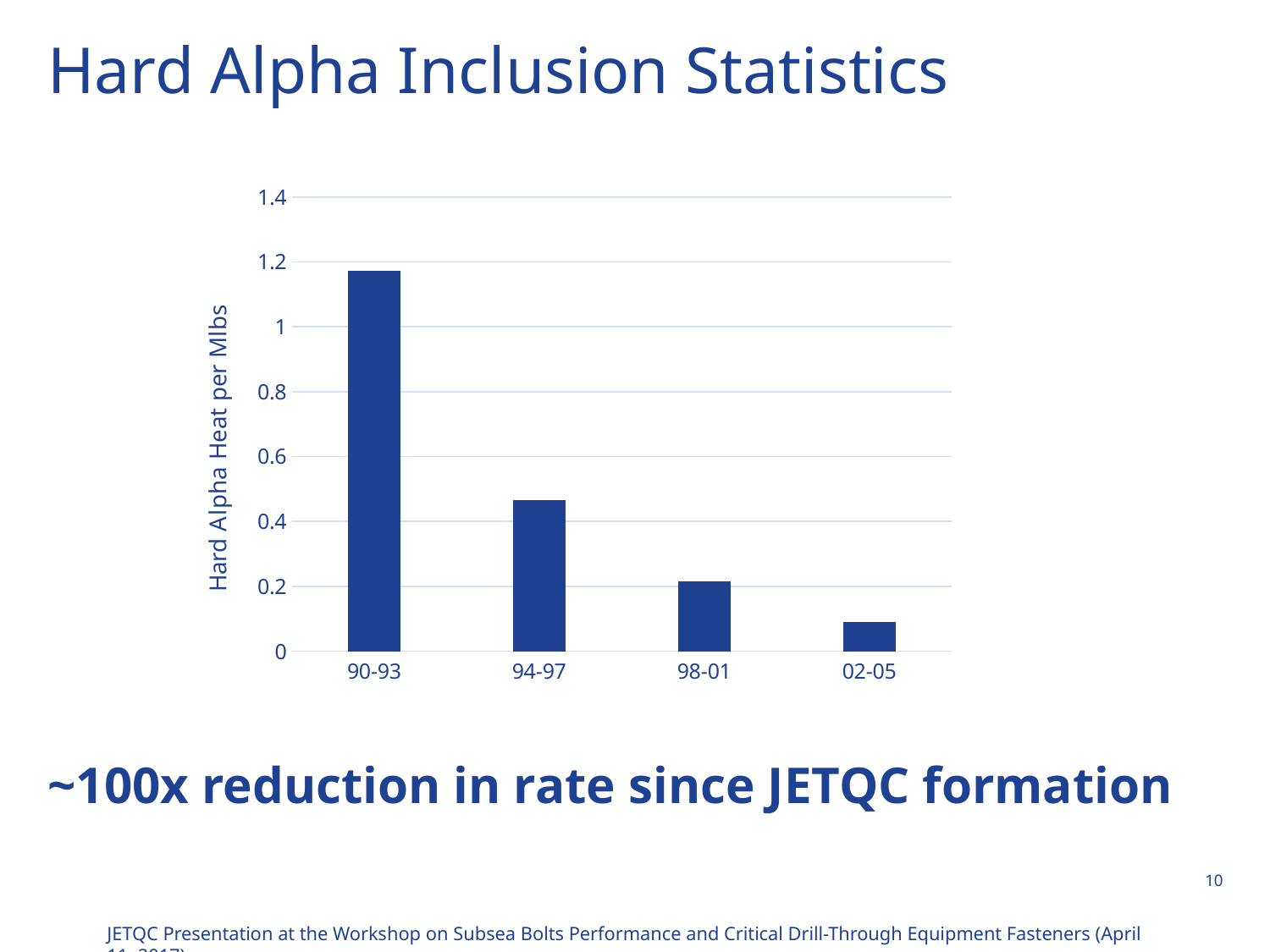
Which category has the highest Hard Alpha Heat per Mlbs? 90-93 Do the values rise or fall from 90-93 to 02-05 along the x axis? fall Is the value for 94-97 greater or less than 0.6? less Which category has the lowest Hard Alpha Heat per Mlbs? 02-05 What kind of chart is shown on the slide? bar chart Which is larger, the value for 94-97 or the value for 98-01? 94-97 Is the value for 98-01 greater or less than 0.4? less Is the value for 90-93 greater or less than 1? greater What is the title of the slide containing the chart? Hard Alpha Inclusion Statistics What is the label on the y axis of the chart? Hard Alpha Heat per Mlbs How many categories are shown on the x axis of the chart? 4